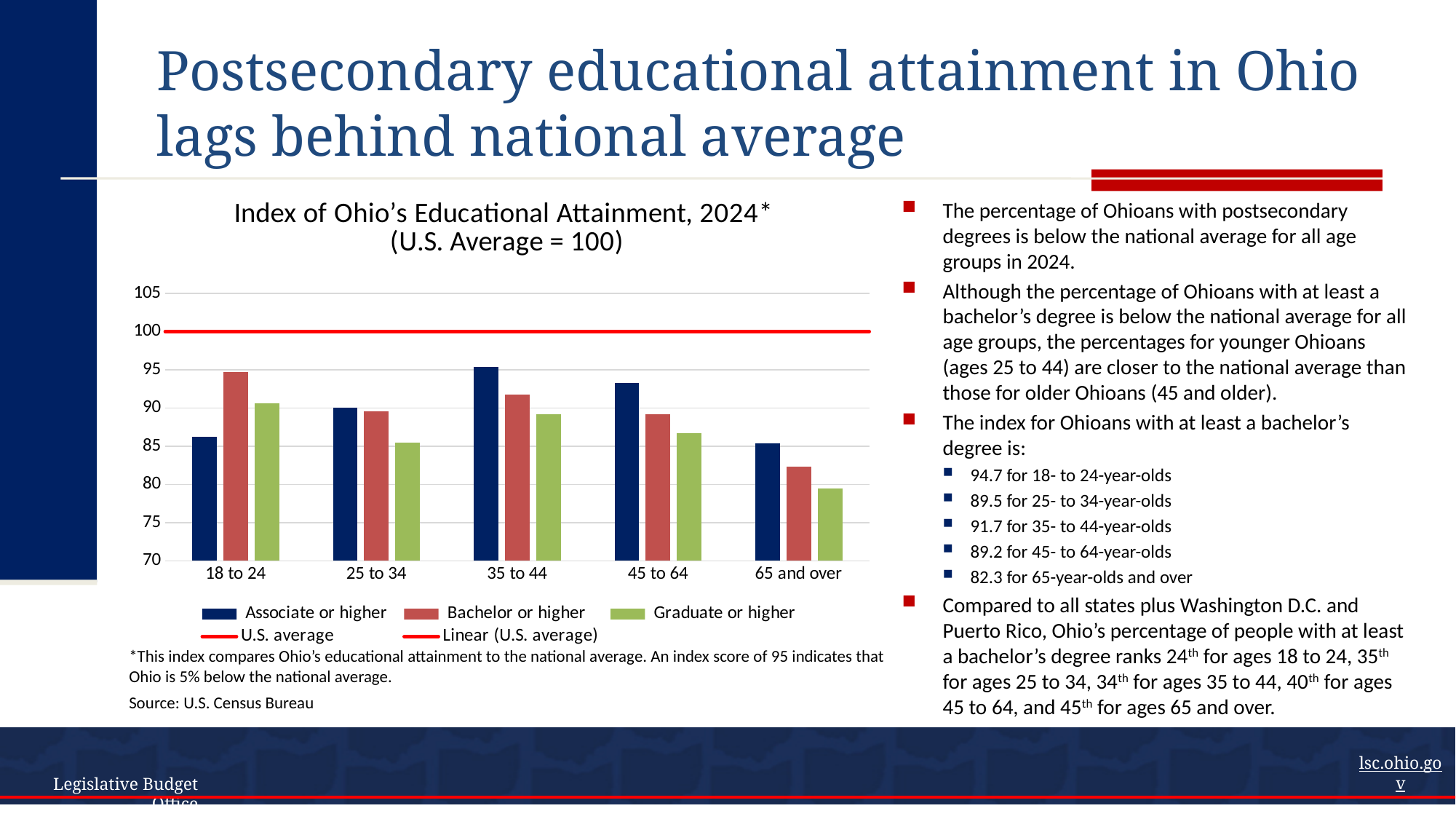
How many entries does the chart's legend list? 5 Is the Graduate or higher value for the 25 to 34 age group greater or less than 90? less Which age group has the highest Bachelor or higher index value? 18 to 24 What value does the red horizontal line on the chart represent? U.S. average = 100 Which age group has the lowest Bachelor or higher index value? 65 and over How many age groups are shown on the x axis of the chart? 5 Does the Bachelor or higher value rise or fall from the 35 to 44 group to the 65 and over group? fall What is the Bachelor or higher index value for the 65 and over age group? 82.3 What is the difference between the Bachelor or higher index for 18 to 24 and for 65 and over? 12.4 What kind of chart is shown on the slide? Bar chart For the 18 to 24 age group, which is larger: Associate or higher or Bachelor or higher? Bachelor or higher What is the Bachelor or higher index value for the 18 to 24 age group? 94.7